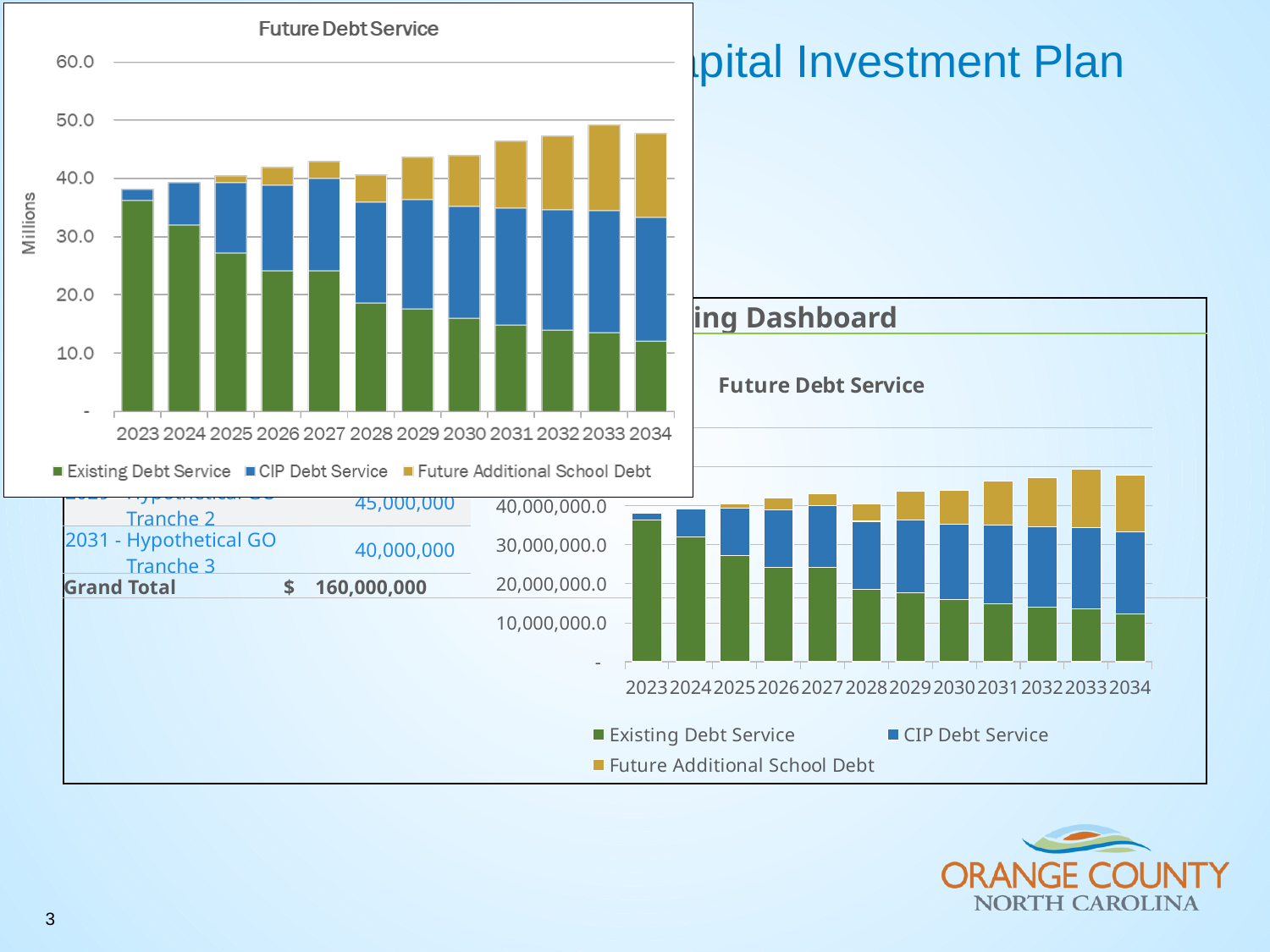
In the top-left 'Future Debt Service' chart, which year has the lowest Existing Debt Service value? 2034 What kind of chart is the top-left 'Future Debt Service' chart? Stacked bar chart How many years are shown on the x axis of the top-left 'Future Debt Service' chart? 12 In the top-left 'Future Debt Service' chart, does the Existing Debt Service series rise or fall from 2023 to 2034? Fall In the top-left 'Future Debt Service' chart, is the Existing Debt Service value for 2034 greater or less than 20.0? less How many series does the legend of the top-left 'Future Debt Service' chart list? 3 In the top-left 'Future Debt Service' chart, is the total stacked bar for 2033 greater or less than 40.0? greater What unit label is shown on the y axis of the top-left 'Future Debt Service' chart? Millions In the top-left 'Future Debt Service' chart, is the Existing Debt Service value for 2023 greater or less than 30.0? greater In the top-left 'Future Debt Service' chart, which year has the highest Existing Debt Service value? 2023 In the top-left 'Future Debt Service' chart, which year has the highest total stacked bar? 2033 In the bottom-right 'Future Debt Service' chart, which series is shown in gold/yellow? Future Additional School Debt